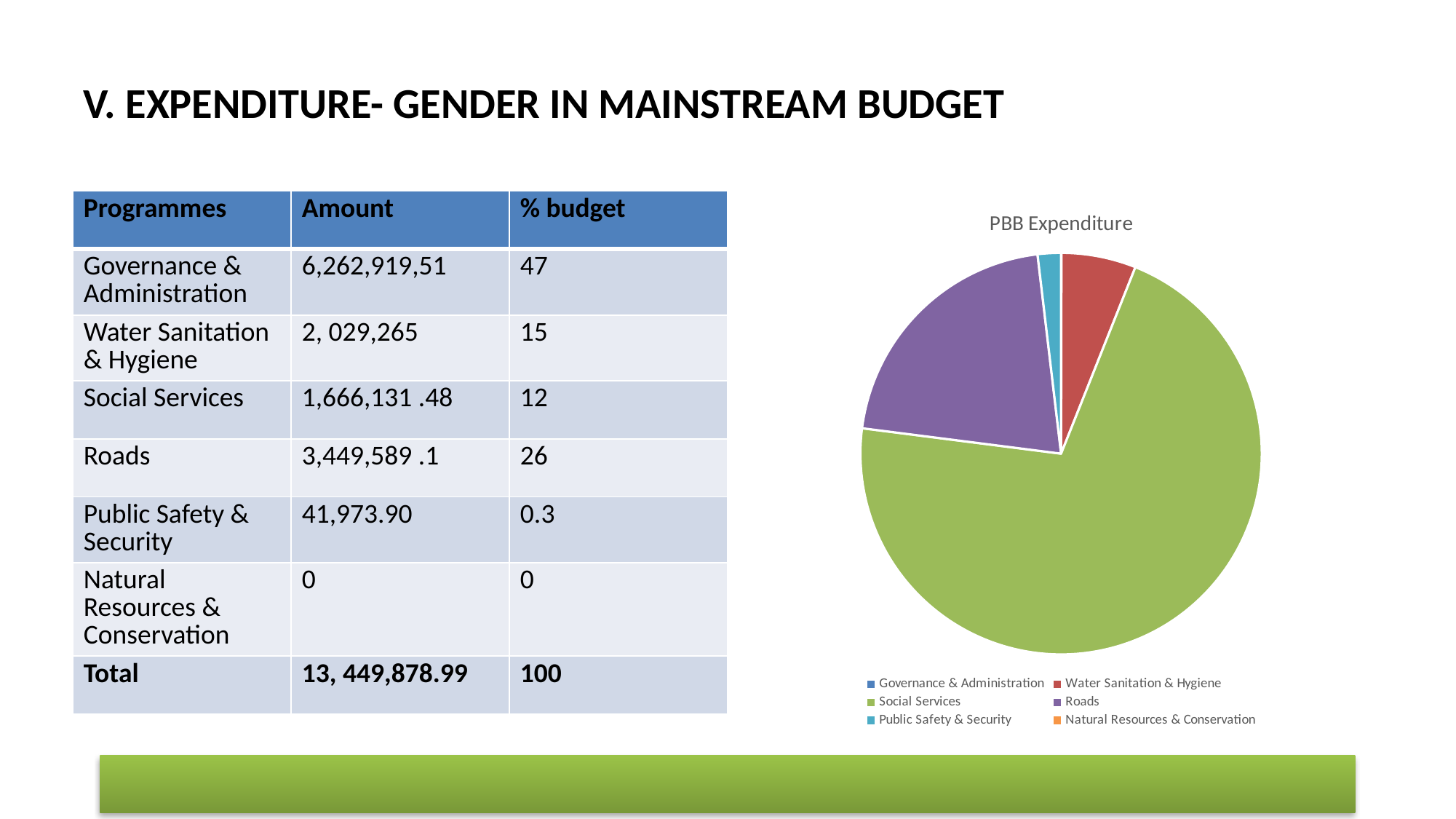
In the PBB Expenditure pie chart, which slice is larger: Social Services or Roads? Social Services What kind of chart is shown on the slide? pie chart What is the title of the chart on the slide? PBB Expenditure In the PBB Expenditure pie chart, which slice is larger: Roads or Water Sanitation & Hygiene? Roads What colour is the Roads slice in the PBB Expenditure pie chart? purple In the PBB Expenditure pie chart, which slice is larger: Water Sanitation & Hygiene or Public Safety & Security? Water Sanitation & Hygiene Which category has the largest slice in the PBB Expenditure pie chart? Social Services How many categories does the legend of the PBB Expenditure chart list? 6